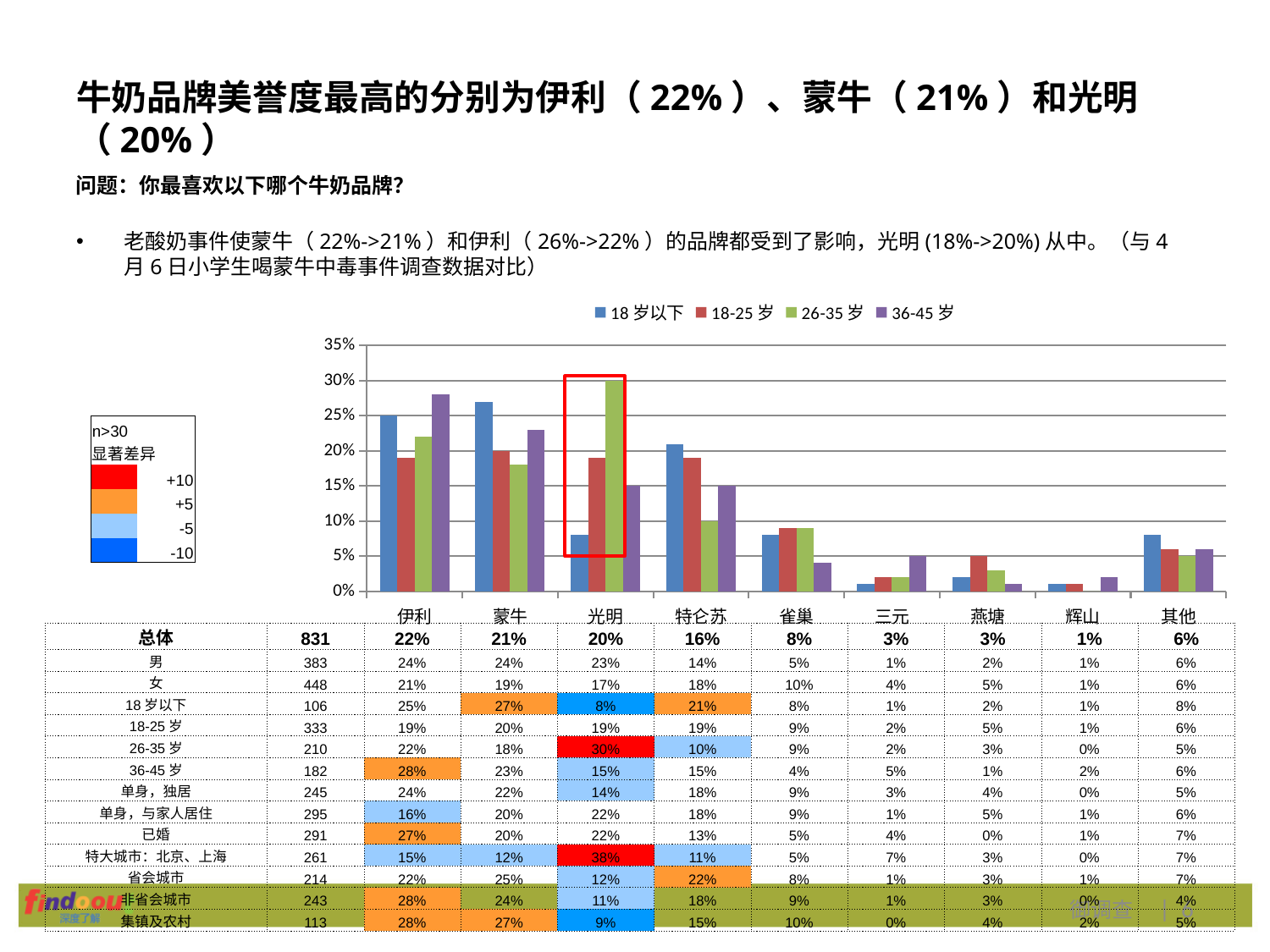
Which brand has the highest value in the 26-35岁 series? 光明 How many series does the chart legend list? 4 For 特仑苏, which is larger: the 18岁以下 value or the 26-35岁 value? 18岁以下 How many milk brand categories are shown on the x axis of the chart? 9 Is the value for 伊利 in the 18岁以下 series greater or less than 20%? greater Which brand has the lowest value in the 26-35岁 series? 辉山 What is the value for 伊利 in the 36-45岁 series? 28% What is the difference between the 26-35岁 value and the 18岁以下 value for 光明? 22% What is the value for 蒙牛 in the 18岁以下 series? 27% Which series is shown in green in the chart legend? 26-35岁 What is the value for 光明 in the 26-35岁 series? 30% What kind of chart is shown on the slide? bar chart